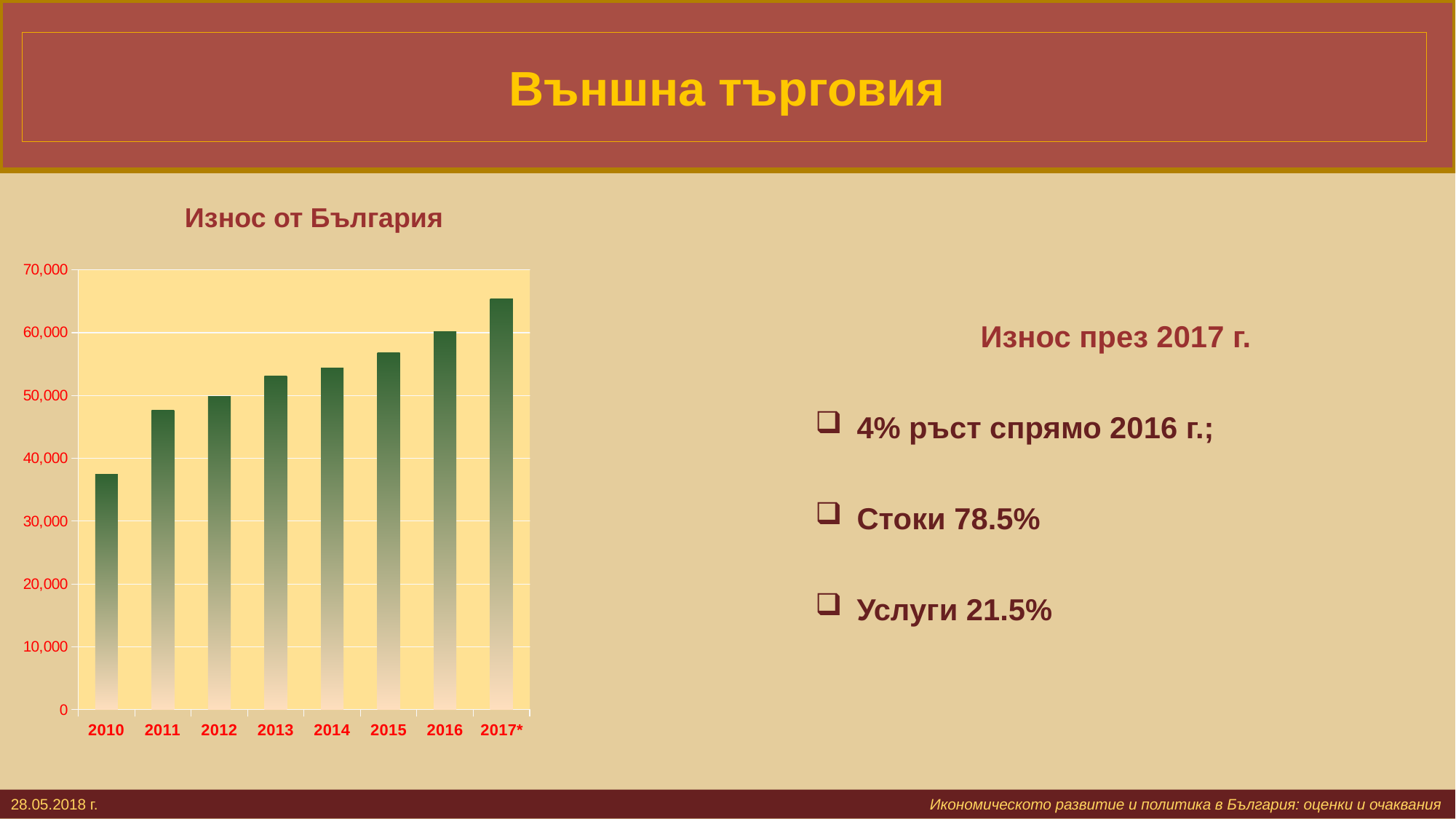
Which is larger, the value for 2013 or the value for 2011? 2013 Which year has the highest bar in the chart? 2017* Is the value for 2011 greater or less than 40,000? greater Do the values rise or fall from 2010 to 2017* in the chart? rise Is the value for 2015 greater or less than 60,000? less Is the value for 2013 greater or less than 50,000? greater How many years are shown on the x axis of the chart? 8 What kind of chart is shown on the slide? bar chart What is the title of the chart? Износ от България Which year has the lowest bar in the chart? 2010